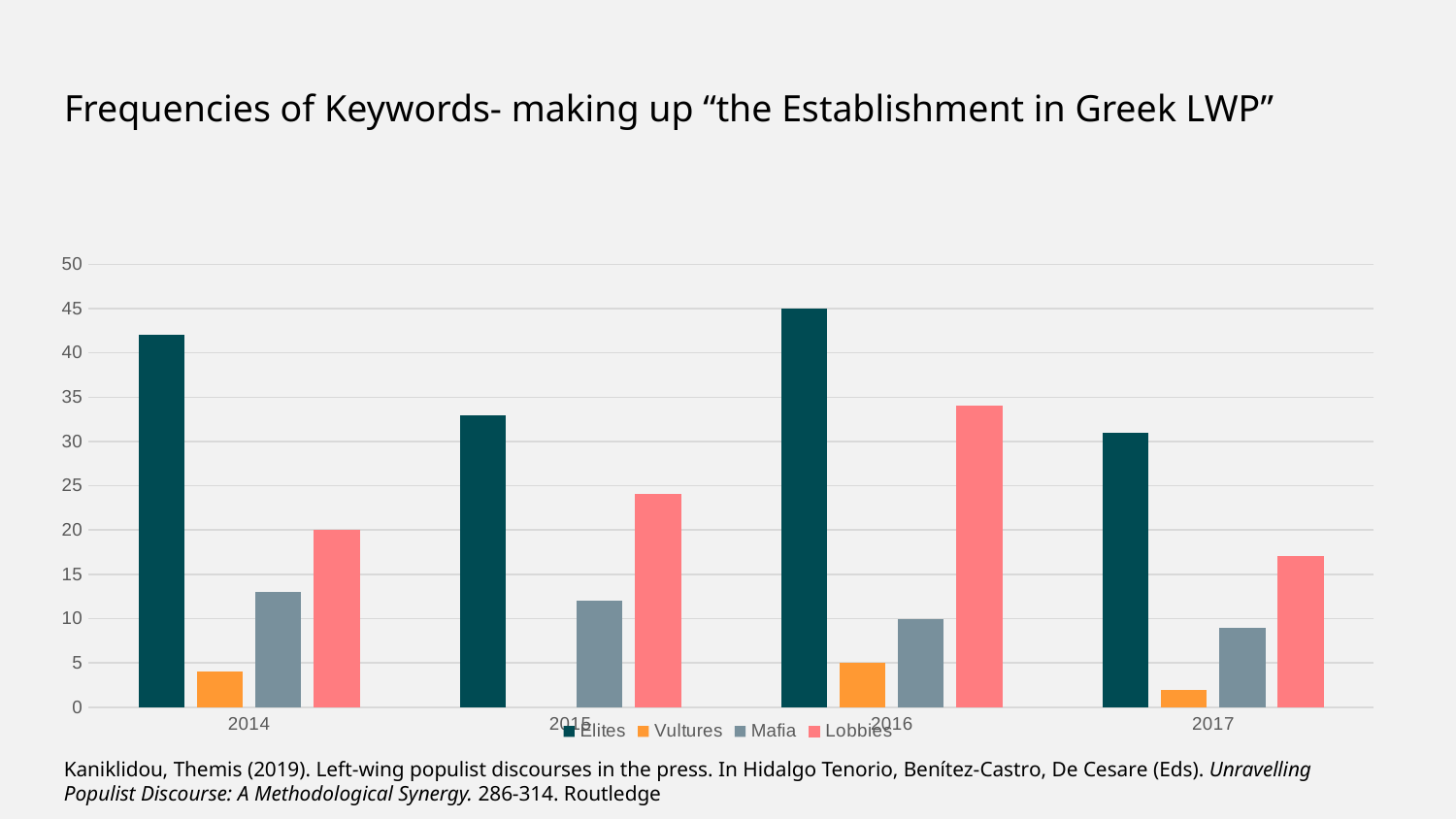
Is the value for Elites in 2014 greater or less than 40? greater In which year is the Lobbies bar highest? 2016 Is the value for Lobbies in 2015 greater or less than 20? greater In which year is the Elites bar highest? 2016 Which is larger in 2016, the Elites bar or the Lobbies bar? Elites In which year is the Elites bar lowest? 2017 Is the value for Mafia in 2017 greater or less than 10? less What is the title of the chart? Frequencies of Keywords- making up "the Establishment in Greek LWP" How many series does the legend list? 4 What kind of chart is shown on the slide? bar chart Which is larger in 2014, the Mafia bar or the Lobbies bar? Lobbies How many years are shown on the x axis? 4